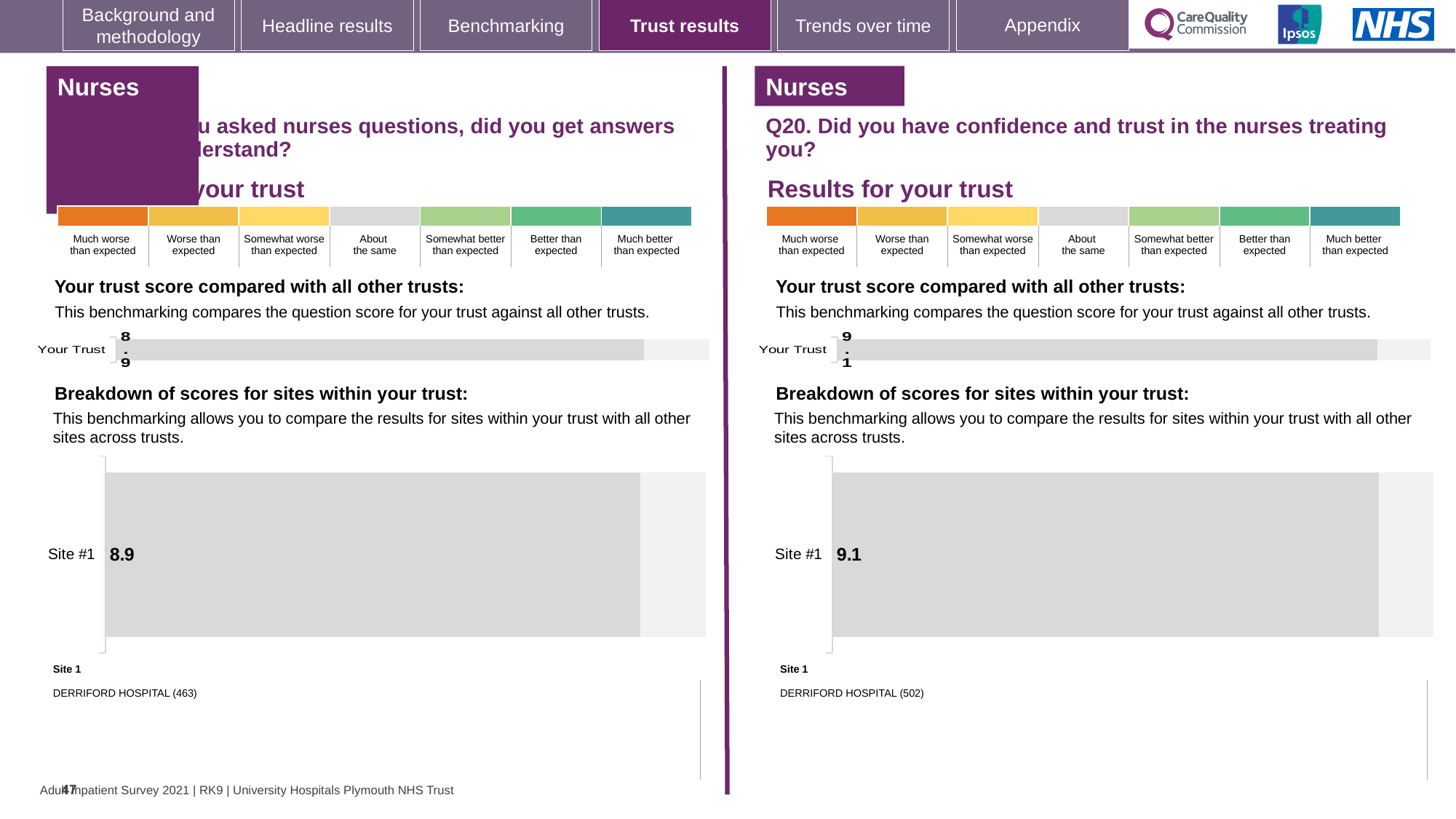
What is the difference between the Site #1 score on the right panel (Q20) and the Site #1 score on the left panel? 0.2 On the left panel, what is the score shown for Site #1 in the breakdown of scores for sites chart? 8.9 What type of chart is used to show the Your Trust score on the right panel (Q20)? Bar chart How many sites are shown in the breakdown of scores for sites chart on the left panel? 1 What type of chart is used for the breakdown of scores for sites on the left panel? Bar chart On the left panel, which site name is listed as Site 1 below the breakdown chart? DERRIFORD HOSPITAL (463) On the left panel, what is the score shown for Your Trust in the trust score chart? 8.9 On the right panel (Q20), what is the score shown for Site #1 in the breakdown of scores for sites chart? 9.1 On the right panel (Q20), which site name is listed as Site 1 below the breakdown chart? DERRIFORD HOSPITAL (502) On the right panel (Q20), what is the score shown for Your Trust in the trust score chart? 9.1 Which is larger: the Your Trust score on the left panel or the Your Trust score on the right panel (Q20)? Right panel (Q20) How many sites are shown in the breakdown of scores for sites chart on the right panel (Q20)? 1